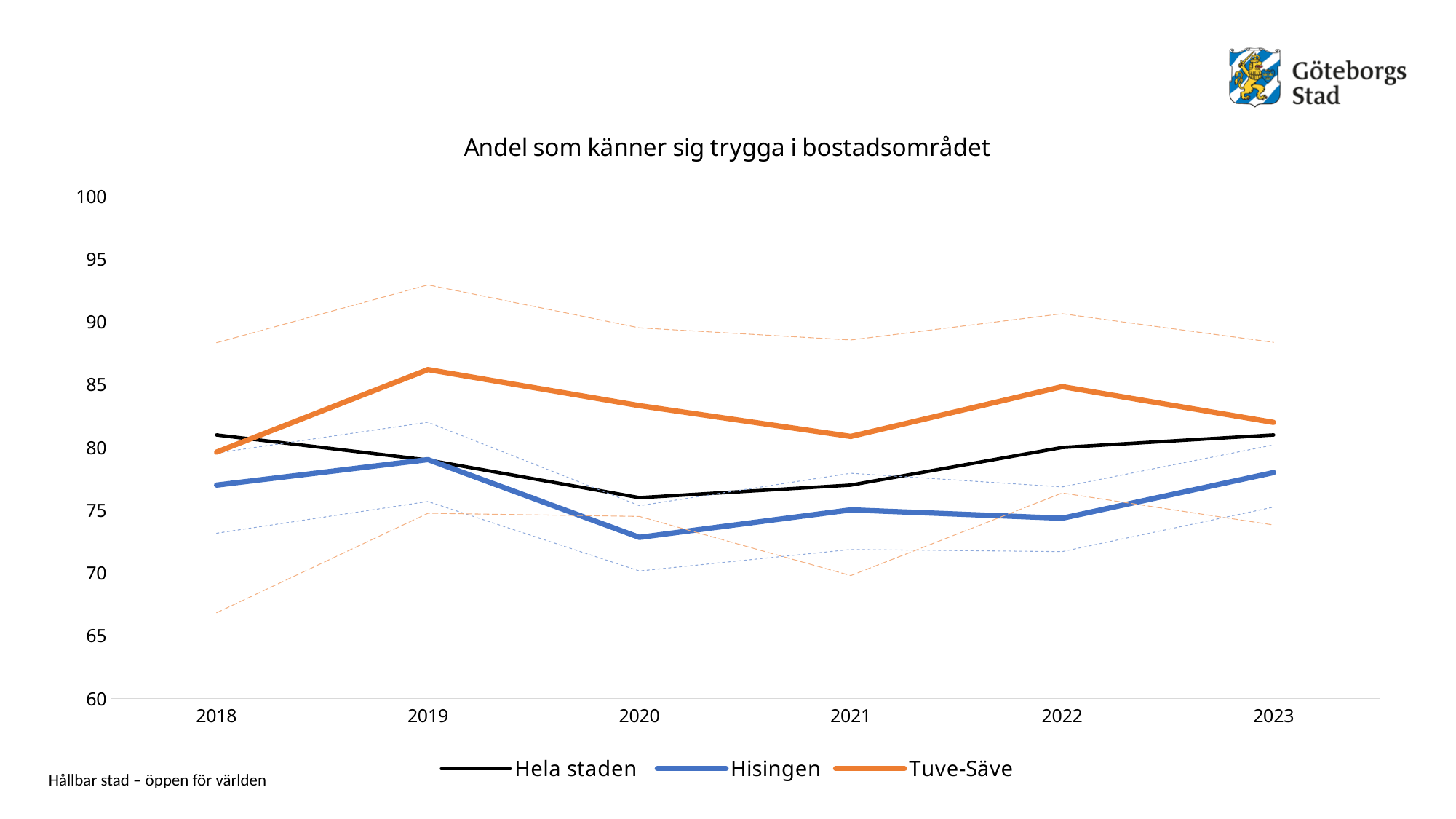
Does the value for Hisingen rise or fall from 2019 to 2020? Fall In 2022, which is higher: Tuve-Säve or Hisingen? Tuve-Säve Is the value for Hisingen in 2020 greater or less than 75? less What kind of chart is shown on the slide? Line chart Which series is drawn in orange in the legend? Tuve-Säve Is the value for Tuve-Säve in 2019 greater or less than 85? greater In which year is the value for Hela staden lowest? 2020 In which year is the value for Hisingen lowest? 2020 In which year is the value for Tuve-Säve highest? 2019 How many series does the legend list? 3 How many years are shown on the x axis? 6 What is the title of the chart? Andel som känner sig trygga i bostadsområdet